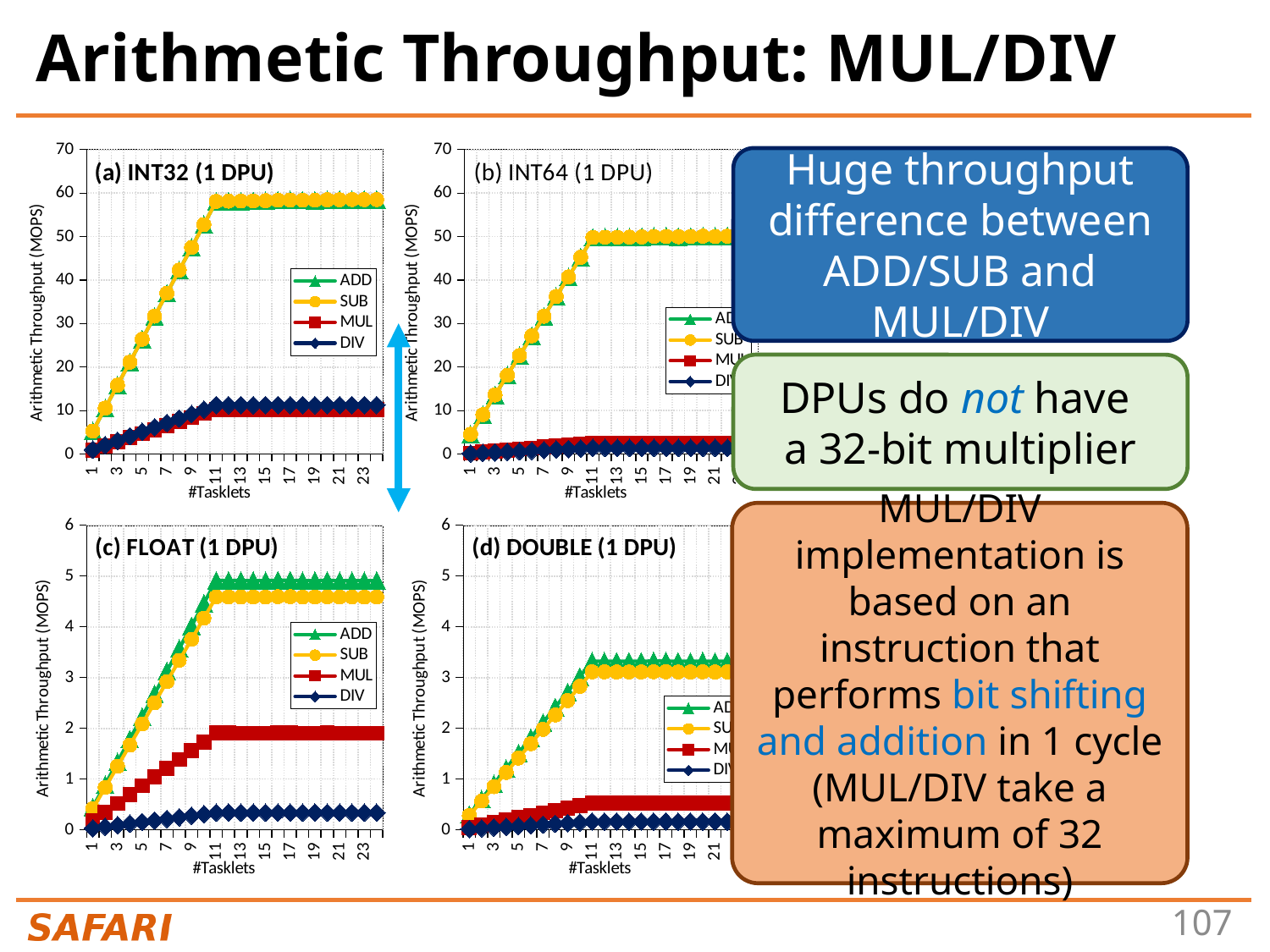
How many series does the legend of chart (c) FLOAT (1 DPU) list? 4 In chart (a) INT32 (1 DPU), is the ADD throughput at 23 tasklets greater or less than 50 MOPS? greater What kind of chart is chart (a) INT32 (1 DPU)? line chart In chart (b) INT64 (1 DPU), is the MUL throughput at 23 tasklets greater or less than 10 MOPS? less In chart (a) INT32 (1 DPU), does the ADD throughput rise or fall as the number of tasklets increases from 1 to 11? rise In chart (c) FLOAT (1 DPU), is the DIV throughput at 23 tasklets greater or less than 1 MOPS? less In chart (a) INT32 (1 DPU), which series has the higher throughput at 23 tasklets, ADD or MUL? ADD What is the label of the y axis in chart (b) INT64 (1 DPU)? Arithmetic Throughput (MOPS) In chart (c) FLOAT (1 DPU), which series has the higher throughput at 23 tasklets, MUL or DIV? MUL In chart (c) FLOAT (1 DPU), which series has the lowest throughput across the tasklet range? DIV